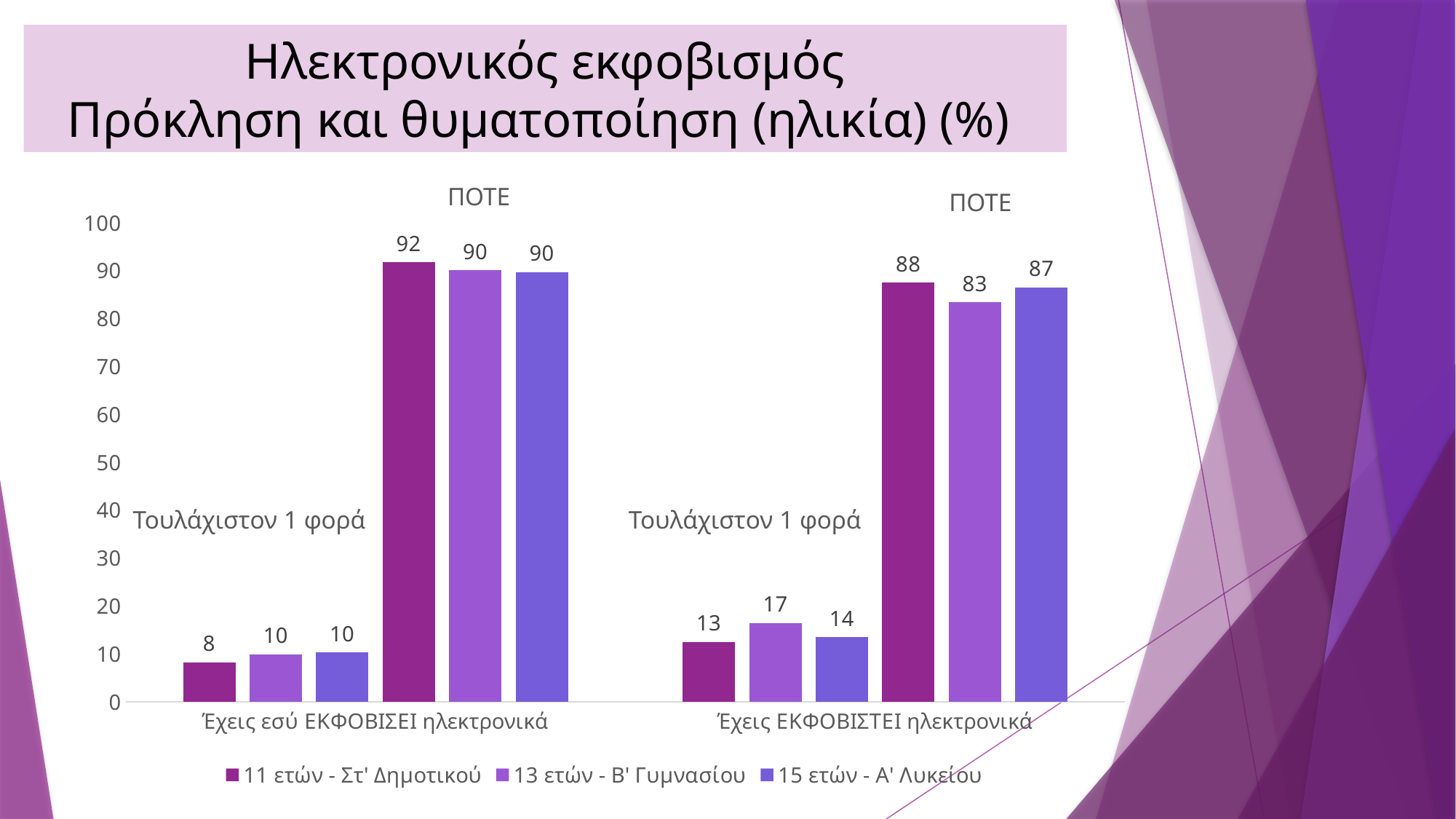
Under 'Τουλάχιστον 1 φορά', is the value for 11 ετών - Στ' Δημοτικού larger for 'Έχεις εσύ ΕΚΦΟΒΙΣΕΙ ηλεκτρονικά' or for 'Έχεις ΕΚΦΟΒΙΣΤΕΙ ηλεκτρονικά'? Έχεις ΕΚΦΟΒΙΣΤΕΙ ηλεκτρονικά What kind of chart is shown on the slide? bar chart How many series does the legend list? 3 What is the title of the slide? Ηλεκτρονικός εκφοβισμός Πρόκληση και θυματοποίηση (ηλικία) (%) What is the difference between the 'ΠΟΤΕ' values for 11 ετών - Στ' Δημοτικού and 13 ετών - Β' Γυμνασίου for 'Έχεις ΕΚΦΟΒΙΣΤΕΙ ηλεκτρονικά'? 5 Is the 'ΠΟΤΕ' value for 11 ετών - Στ' Δημοτικού for 'Έχεις εσύ ΕΚΦΟΒΙΣΕΙ ηλεκτρονικά' greater or less than 90? greater What is the value for 11 ετών - Στ' Δημοτικού under 'Τουλάχιστον 1 φορά' for 'Έχεις εσύ ΕΚΦΟΒΙΣΕΙ ηλεκτρονικά'? 8 What is the value for 15 ετών - Α' Λυκείου under 'Τουλάχιστον 1 φορά' for 'Έχεις ΕΚΦΟΒΙΣΤΕΙ ηλεκτρονικά'? 14 What is the value for 13 ετών - Β' Γυμνασίου under 'ΠΟΤΕ' for 'Έχεις ΕΚΦΟΒΙΣΤΕΙ ηλεκτρονικά'? 83 What is the difference between the 'Τουλάχιστον 1 φορά' values for 13 ετών - Β' Γυμνασίου and 11 ετών - Στ' Δημοτικού for 'Έχεις εσύ ΕΚΦΟΒΙΣΕΙ ηλεκτρονικά'? 2 Which age group has the highest value under 'Τουλάχιστον 1 φορά' for 'Έχεις ΕΚΦΟΒΙΣΤΕΙ ηλεκτρονικά'? 13 ετών - Β' Γυμνασίου Which age group has the lowest value under 'ΠΟΤΕ' for 'Έχεις ΕΚΦΟΒΙΣΤΕΙ ηλεκτρονικά'? 13 ετών - Β' Γυμνασίου